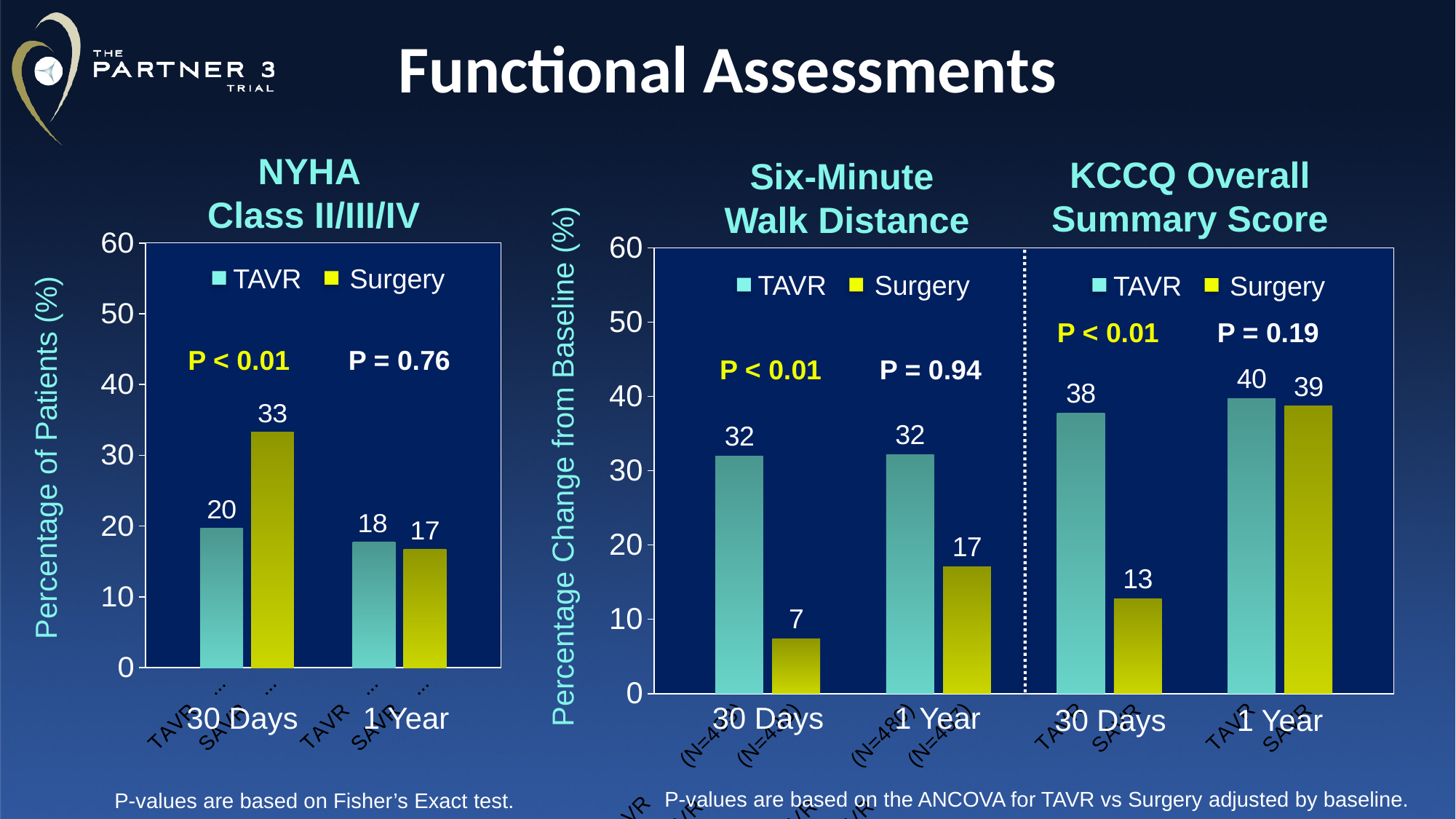
In the Six-Minute Walk Distance chart, what is the value for Surgery at 30 Days? 7 In the NYHA Class II/III/IV chart, what is the value for TAVR at 1 Year? 18 In the NYHA Class II/III/IV chart, what is the difference between the Surgery and TAVR values at 30 Days? 13 In the KCCQ Overall Summary Score chart, what is the value for TAVR at 1 Year? 40 In the NYHA Class II/III/IV chart, what is the value for Surgery at 30 Days? 33 In the KCCQ Overall Summary Score chart, does the Surgery value rise or fall from 30 Days to 1 Year? rise In the KCCQ Overall Summary Score chart, what is the value for Surgery at 30 Days? 13 What kind of chart is the Six-Minute Walk Distance chart? bar chart In the Six-Minute Walk Distance chart, what is the value for TAVR at 1 Year? 32 In the KCCQ Overall Summary Score chart, what is the difference between the TAVR and Surgery values at 30 Days? 25 How many series does the legend of the NYHA Class II/III/IV chart list? 2 In the Six-Minute Walk Distance chart, which is larger at 1 Year, TAVR or Surgery? TAVR